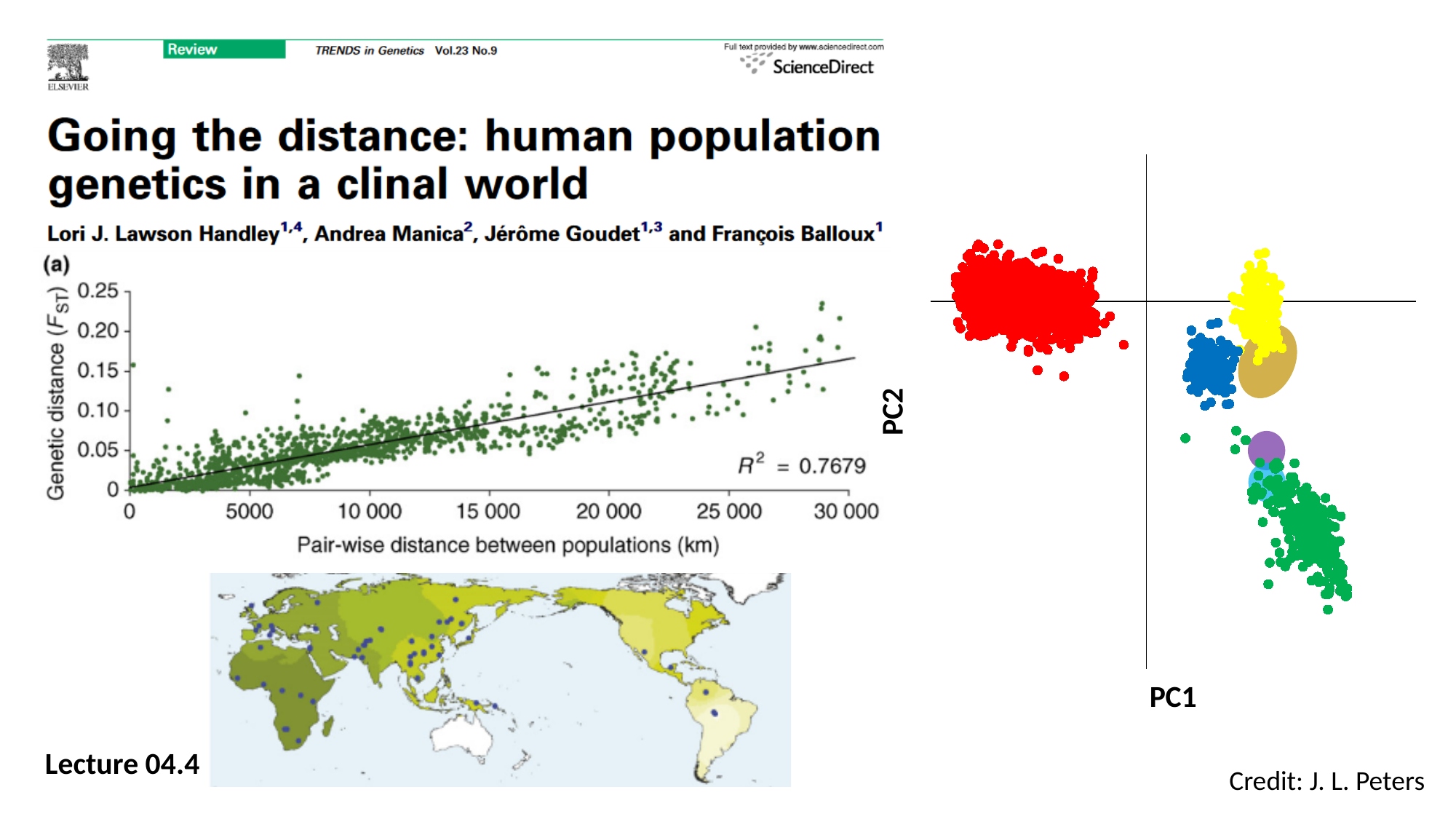
What kind of chart is the right chart with PC1 and PC2 axes? Scatter plot On the left chart, what is the label of the y axis? Genetic distance (FST) On the left chart, what R² value is printed? 0.7679 On the right chart, which coloured cluster lies to the left of the vertical axis? Red On the right chart, which coloured cluster extends lowest on PC2? Green On the left chart, what is the label of the x axis? Pair-wise distance between populations (km) On the left chart, is the fitted line at 30 000 km greater or less than 0.10? greater What kind of chart is the left chart showing genetic distance against pair-wise distance? Scatter plot On the right chart, what is the label of the horizontal axis? PC1 On the left chart, does genetic distance rise or fall as pair-wise distance increases? Rise On the left chart, what is the highest tick value on the y axis? 0.25 On the left chart, what is the largest value shown on the x axis? 30 000